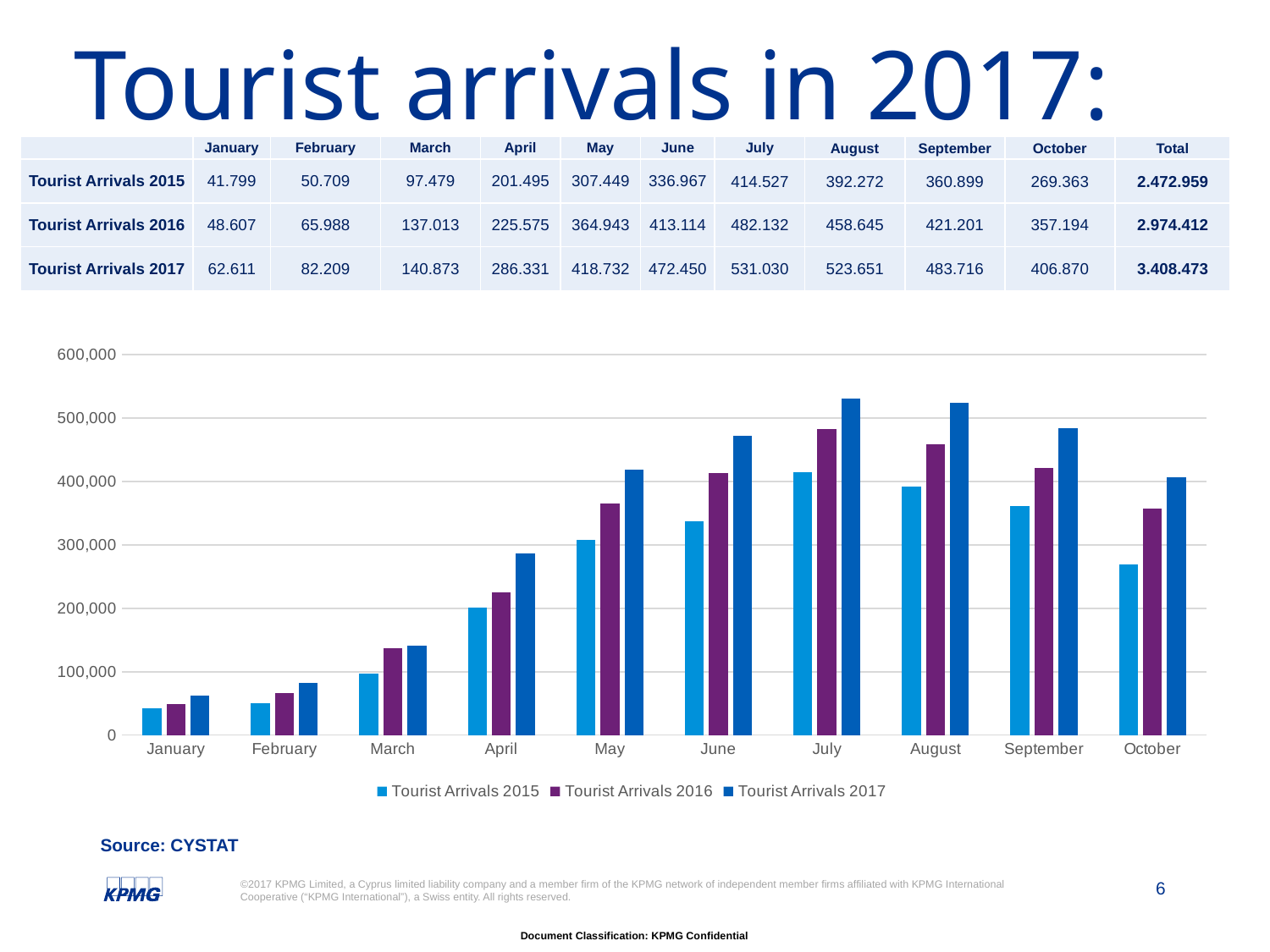
What is the value for Tourist Arrivals 2017 in July? 531.030 Which is larger in October: Tourist Arrivals 2016 or Tourist Arrivals 2017? Tourist Arrivals 2017 In which month is Tourist Arrivals 2015 lowest? January How many months are shown on the x axis of the chart? 10 What is the difference between Tourist Arrivals 2017 and Tourist Arrivals 2016 in August? 65.006 What kind of chart is shown on the slide? bar chart What is the value for Tourist Arrivals 2015 in January? 41.799 Is the value for Tourist Arrivals 2017 in June greater or less than 400,000? greater What is the value for Tourist Arrivals 2016 in May? 364.943 How many series does the chart legend list? 3 In which month is Tourist Arrivals 2017 highest? July Do the Tourist Arrivals 2017 values rise or fall from January to July? rise